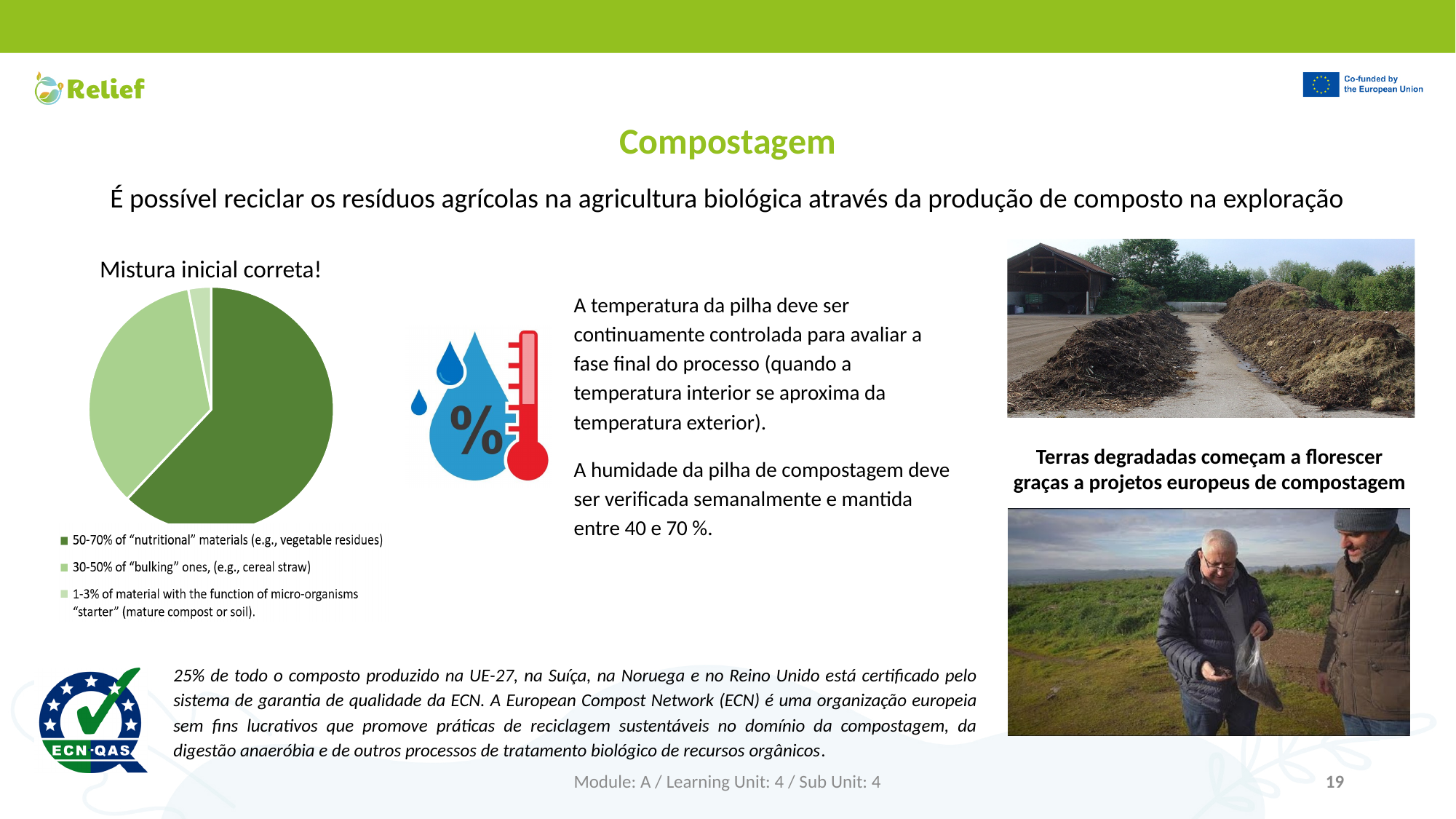
What kind of chart is shown under "Mistura inicial correta!"? pie chart Which slice is larger in the pie chart: "bulking" ones or the micro-organisms "starter" material? "bulking" ones Which legend category has the smallest slice of the pie chart? 1-3% of material with the function of micro-organisms "starter" (mature compost or soil) Which legend category has the largest slice of the pie chart? 50-70% of "nutritional" materials (e.g., vegetable residues) What example is given in the legend for "bulking" materials? cereal straw How many slices does the pie chart have? 3 What is the title shown above the pie chart? Mistura inicial correta! How many entries does the pie chart's legend list? 3 Which slice is larger in the pie chart: "nutritional" materials or "bulking" ones? "nutritional" materials